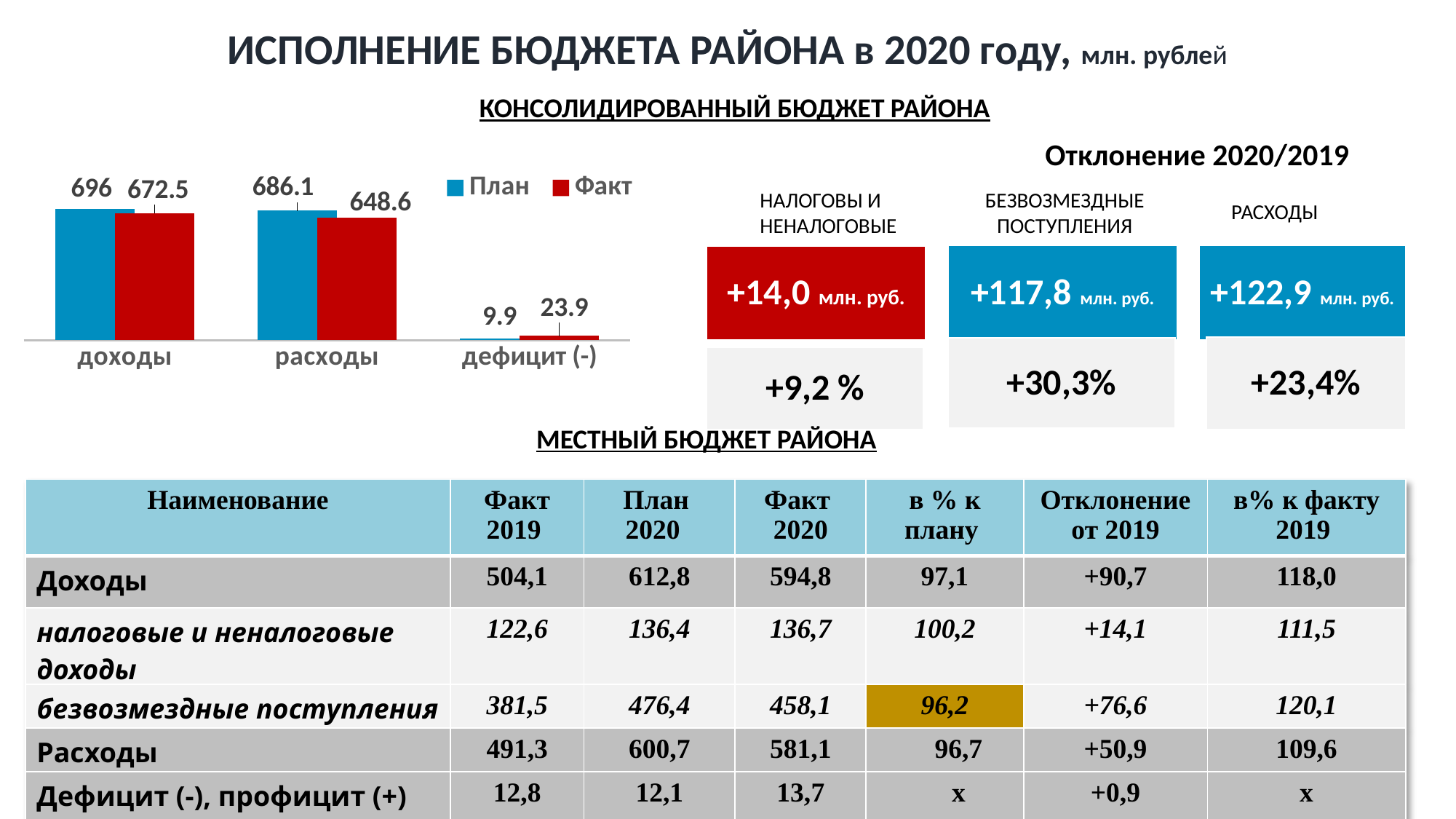
What is the Факт value for расходы in the bar chart? 648.6 What is the difference between the План and Факт values for доходы in the bar chart? 23.5 How many series does the legend of the bar chart list? 2 In the bar chart, is the Факт value for дефицит (-) larger or smaller than its План value? larger What is the План value for дефицит (-) in the bar chart? 9.9 What is the difference between the План and Факт values for расходы in the bar chart? 37.5 What is the Факт value for дефицит (-) in the bar chart? 23.9 Which category has the highest План value in the bar chart? доходы Which category has the lowest Факт value in the bar chart? дефицит (-) How many categories are shown on the x axis of the bar chart? 3 What is the План value for доходы in the bar chart? 696 What type of chart is used to show План and Факт for доходы, расходы and дефицит (-)? bar chart